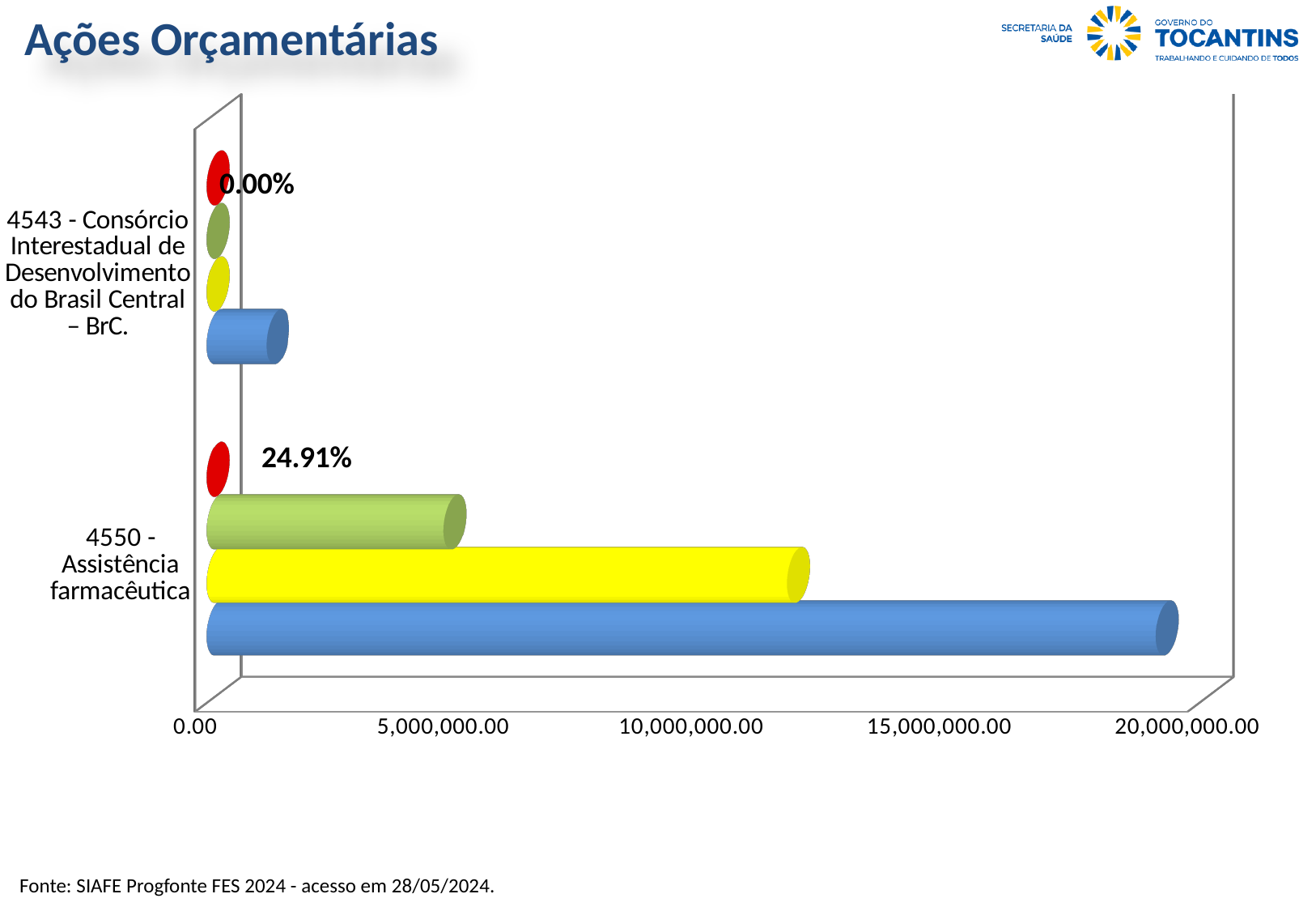
What is the title of the slide containing the chart? Ações Orçamentárias What percentage label is shown for the category 4550 - Assistência farmacêutica? 24.91% What percentage label is shown for the category 4543 - Consórcio Interestadual de Desenvolvimento do Brasil Central – BrC.? 0.00% Is the value of the yellow bar for 4550 - Assistência farmacêutica greater or less than 10,000,000.00? greater How many categories are shown on the vertical axis of the chart? 2 Is the value of the blue bar for 4550 - Assistência farmacêutica greater or less than 15,000,000.00? greater What is the highest value shown on the horizontal axis of the chart? 20,000,000.00 Which category has the highest percentage label? 4550 - Assistência farmacêutica What kind of chart is shown on the slide? bar chart Is the value of the blue bar for 4543 - Consórcio Interestadual de Desenvolvimento do Brasil Central – BrC. greater or less than 5,000,000.00? less Which category has the longer blue bar, 4550 - Assistência farmacêutica or 4543 - Consórcio Interestadual de Desenvolvimento do Brasil Central – BrC.? 4550 - Assistência farmacêutica